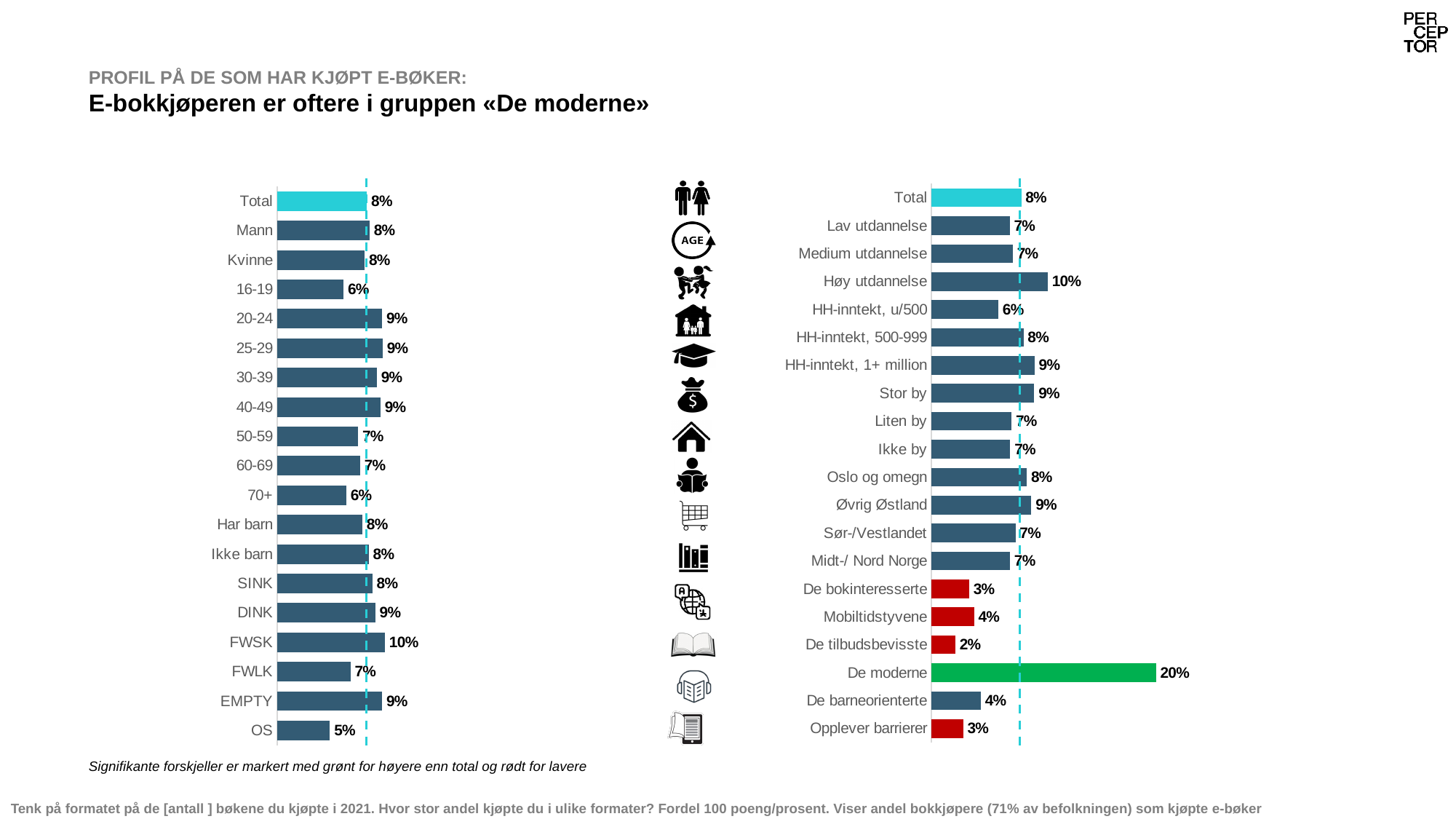
In the right chart, what is the value for Høy utdannelse? 10% In the right chart, which category has the lowest value? De tilbudsbevisste In the right chart, which category has the highest value? De moderne In the right chart, what colour is the bar for De moderne? Green In the right chart, what is the value for De moderne? 20% In the left chart, which category has the lowest value? OS What type of chart is the left chart? Bar chart In the right chart, what is the difference between De moderne and Total? 12% How many categories are shown in the right chart? 20 In the left chart, what is the value for FWSK? 10% In the left chart, which is larger, the value for 16-19 or the value for 20-24? 20-24 In the left chart, what is the value for OS? 5%